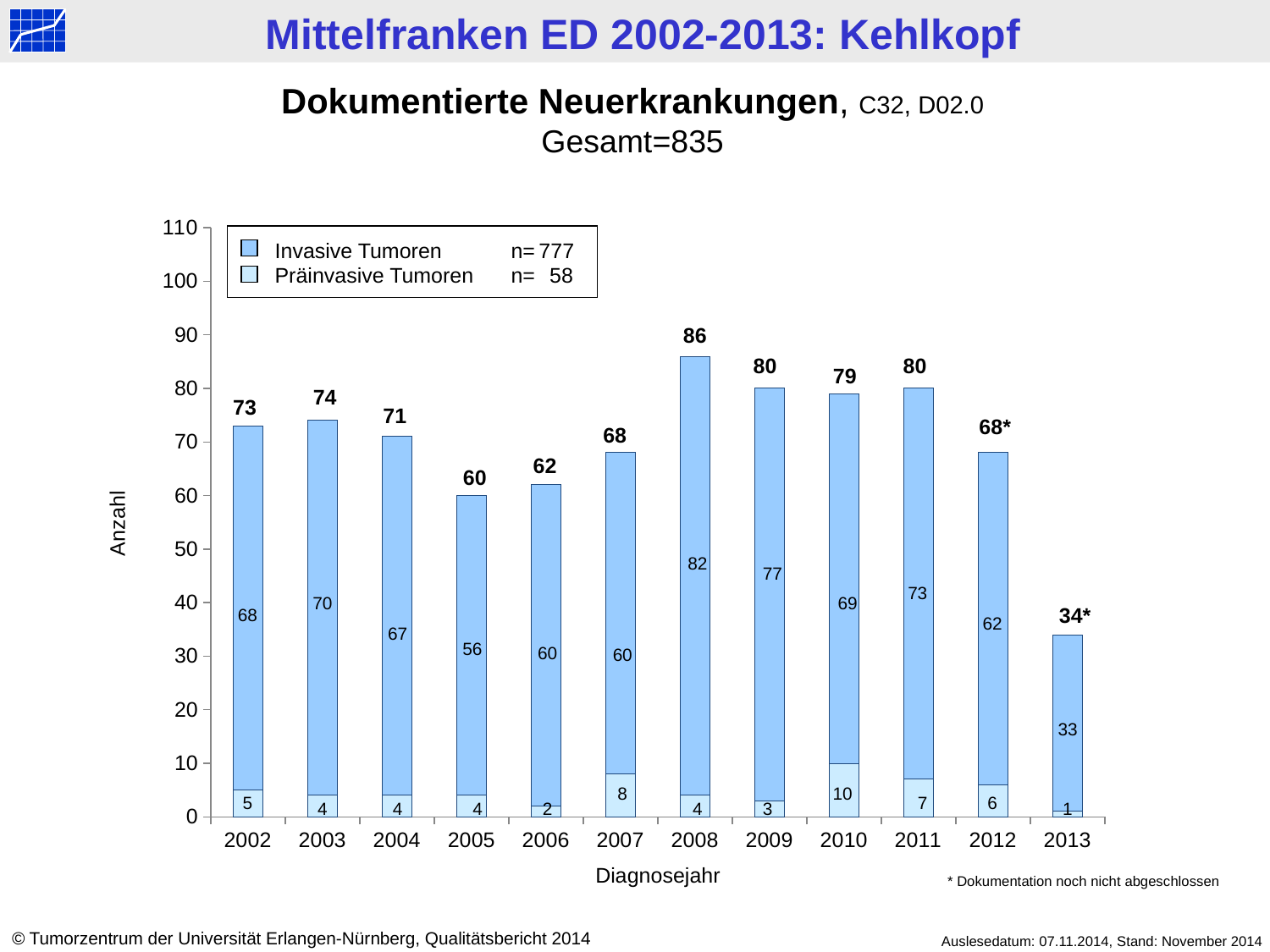
What is the n value given in the legend for Invasive Tumoren? 777 What is the value for Invasive Tumoren in 2008? 82 How many years are shown on the x axis? 12 Which year has the lowest total number of documented new cases? 2013 What is the difference between the total for 2008 and the total for 2007? 18 Which is larger, the Invasive Tumoren value for 2003 or for 2004? 2003 What kind of chart is shown on the slide? Stacked bar chart What is the label of the y axis? Anzahl What is the value for Präinvasive Tumoren in 2010? 10 How many series does the legend list? 2 Which year has the highest total number of documented new cases? 2008 What is the total of the stacked bar for 2009? 80